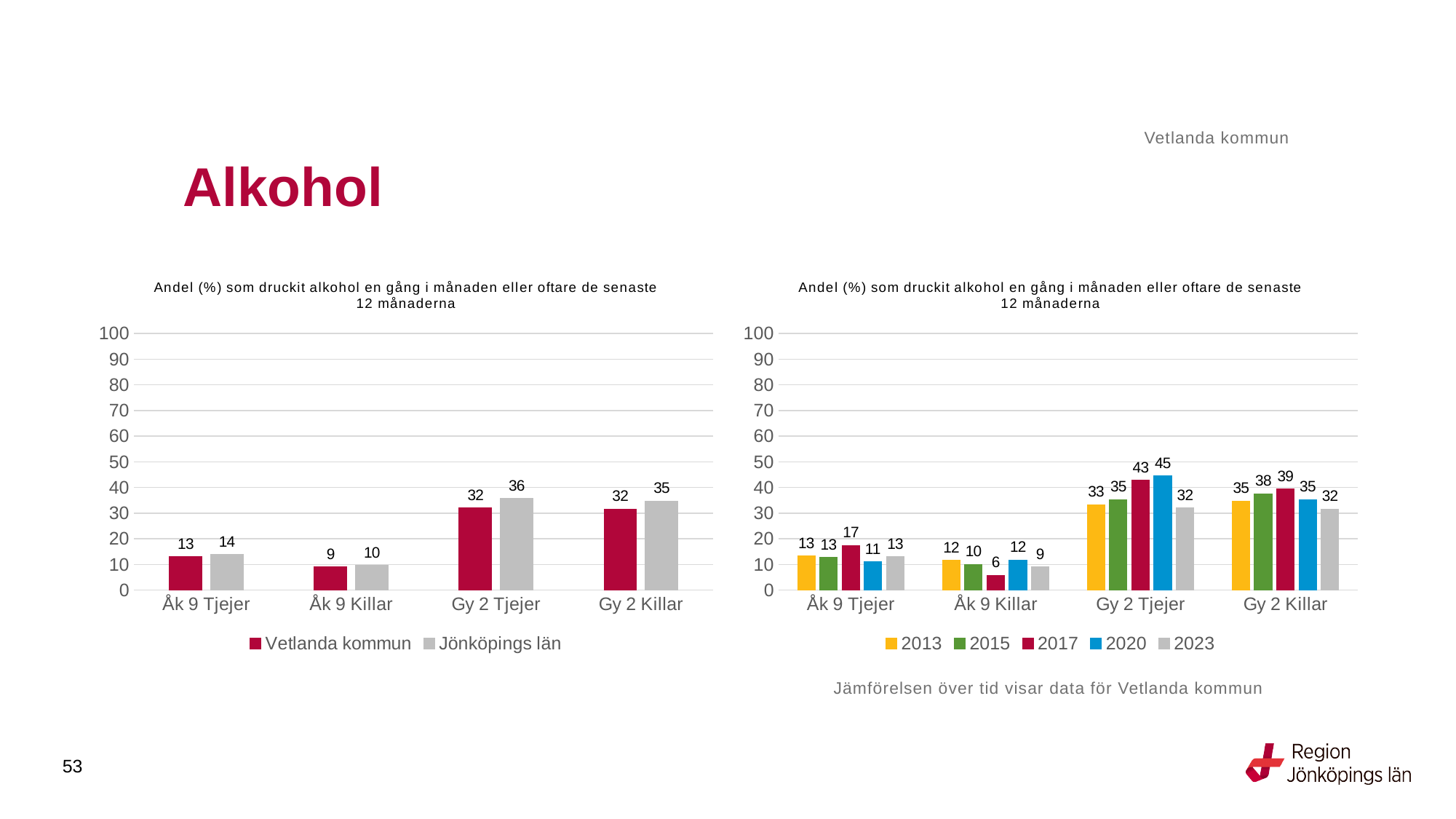
What kind of chart is the left chart? bar chart In the right chart, how many series does the legend list? 5 In the left chart, how many series does the legend list? 2 In the left chart, what is the value for Jönköpings län for Åk 9 Killar? 10 In the right chart, what is the difference between the 2020 and 2023 values for Gy 2 Tjejer? 13 In the left chart, what is the difference between Jönköpings län and Vetlanda kommun for Gy 2 Tjejer? 4 In the right chart, is the 2023 value for Gy 2 Tjejer larger or smaller than the 2013 value for Gy 2 Tjejer? smaller In the left chart, what is the value for Vetlanda kommun for Gy 2 Tjejer? 32 In the left chart, which category has the lowest value for Vetlanda kommun? Åk 9 Killar In the right chart, which year has the highest value for Gy 2 Killar? 2017 In the right chart, what is the value for 2017 for Åk 9 Killar? 6 In the right chart, what is the value for 2020 for Gy 2 Tjejer? 45